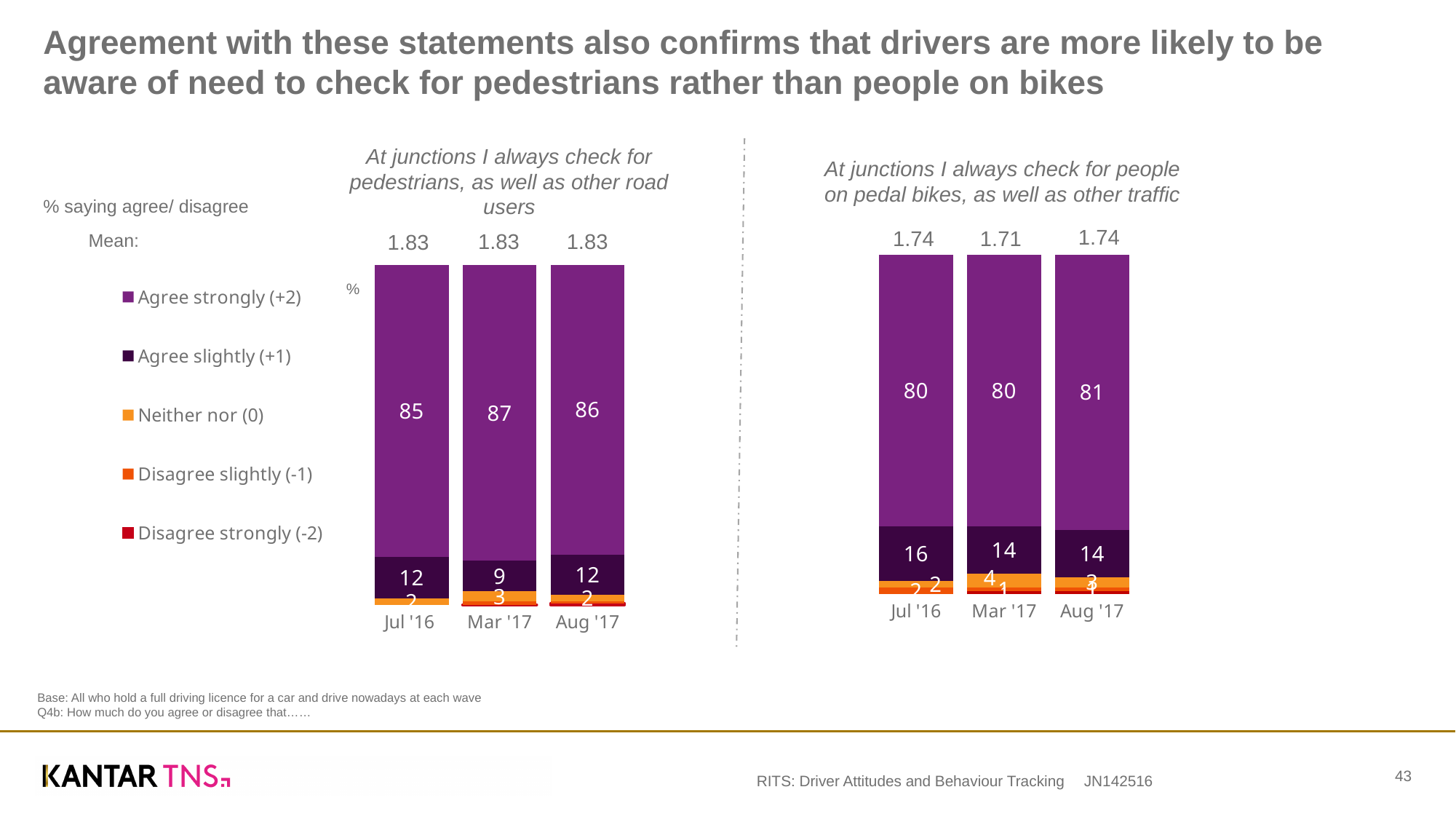
In the chart 'At junctions I always check for people on pedal bikes, as well as other traffic', what percentage agreed strongly in Aug '17? 81 How many series does the legend list? 5 In the chart 'At junctions I always check for people on pedal bikes, as well as other traffic', what is the mean score shown for Mar '17? 1.71 In the chart 'At junctions I always check for pedestrians, as well as other road users', which wave has the highest 'Agree strongly' percentage? Mar '17 In the chart 'At junctions I always check for people on pedal bikes, as well as other traffic', what percentage agreed slightly in Jul '16? 16 What is the difference between the 'Agree strongly' percentage for Mar '17 in the pedestrians chart and the 'Agree strongly' percentage for Mar '17 in the pedal bikes chart? 7 In the chart 'At junctions I always check for people on pedal bikes, as well as other traffic', which wave has the lowest 'Agree slightly' percentage? Mar '17 and Aug '17 (both 14) In the chart 'At junctions I always check for pedestrians, as well as other road users', what percentage agreed strongly in Mar '17? 87 How many waves (categories) are shown on the x axis of each chart? 3 In the chart 'At junctions I always check for pedestrians, as well as other road users', what is the mean score shown for Aug '17? 1.83 What type of chart is used on this slide? Stacked bar chart Is the 'Agree slightly' percentage for Jul '16 larger in the pedestrians chart or in the pedal bikes chart? Pedal bikes chart